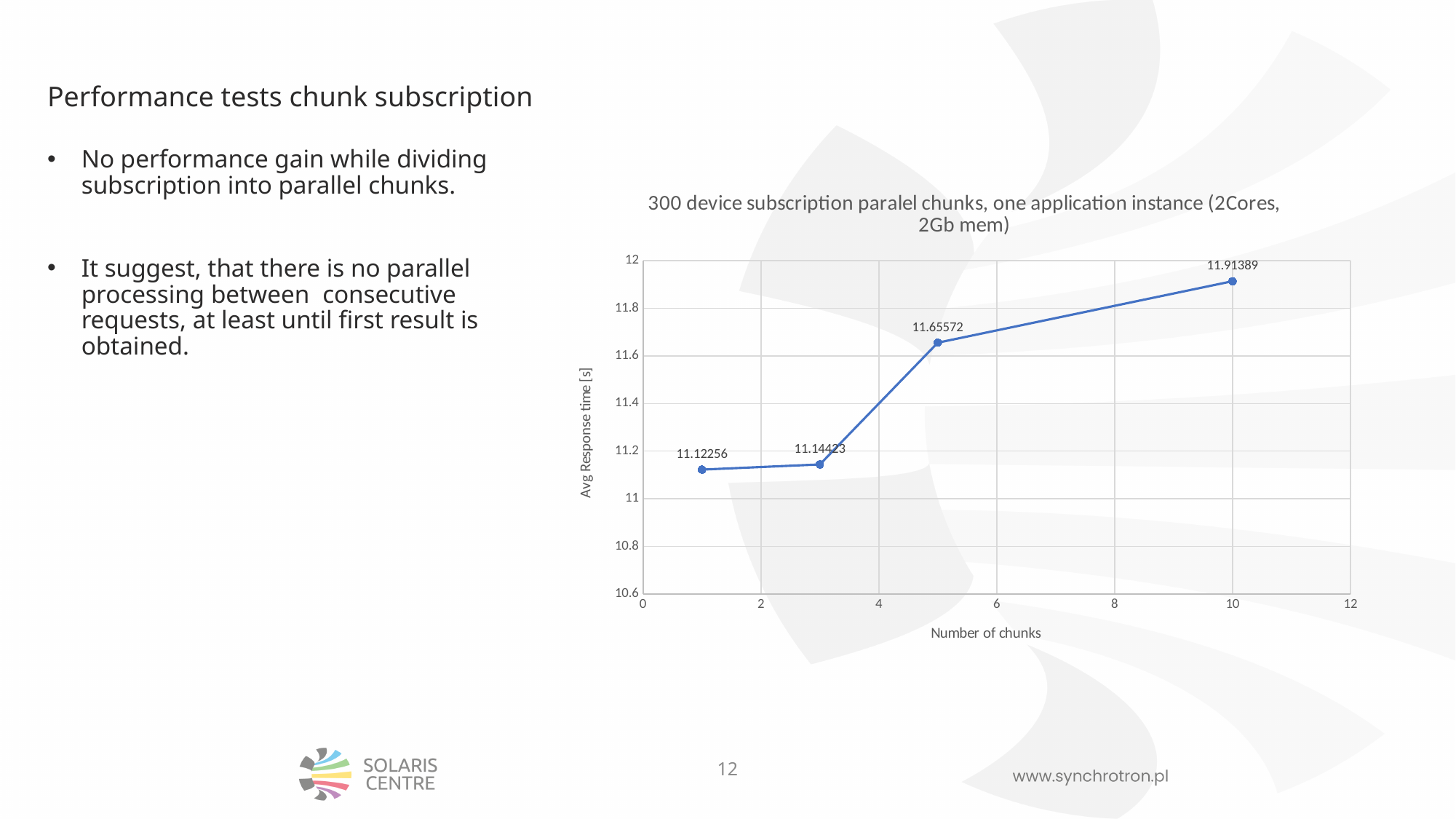
What is the average response time for 5 chunks? 11.65572 At which number of chunks is the average response time highest? 10 What kind of chart is shown on the slide? line chart Is the average response time for 10 chunks greater or less than 11.8? greater What is the difference in average response time between 5 chunks and 3 chunks? 0.51149 What is the average response time for 1 chunk? 11.12256 What is the average response time for 10 chunks? 11.91389 Which has a larger average response time, 5 chunks or 3 chunks? 5 chunks What is the difference in average response time between 10 chunks and 1 chunk? 0.79133 Does the average response time rise or fall as the number of chunks increases? rise At which number of chunks is the average response time lowest? 1 How many data points are plotted on the chart? 4